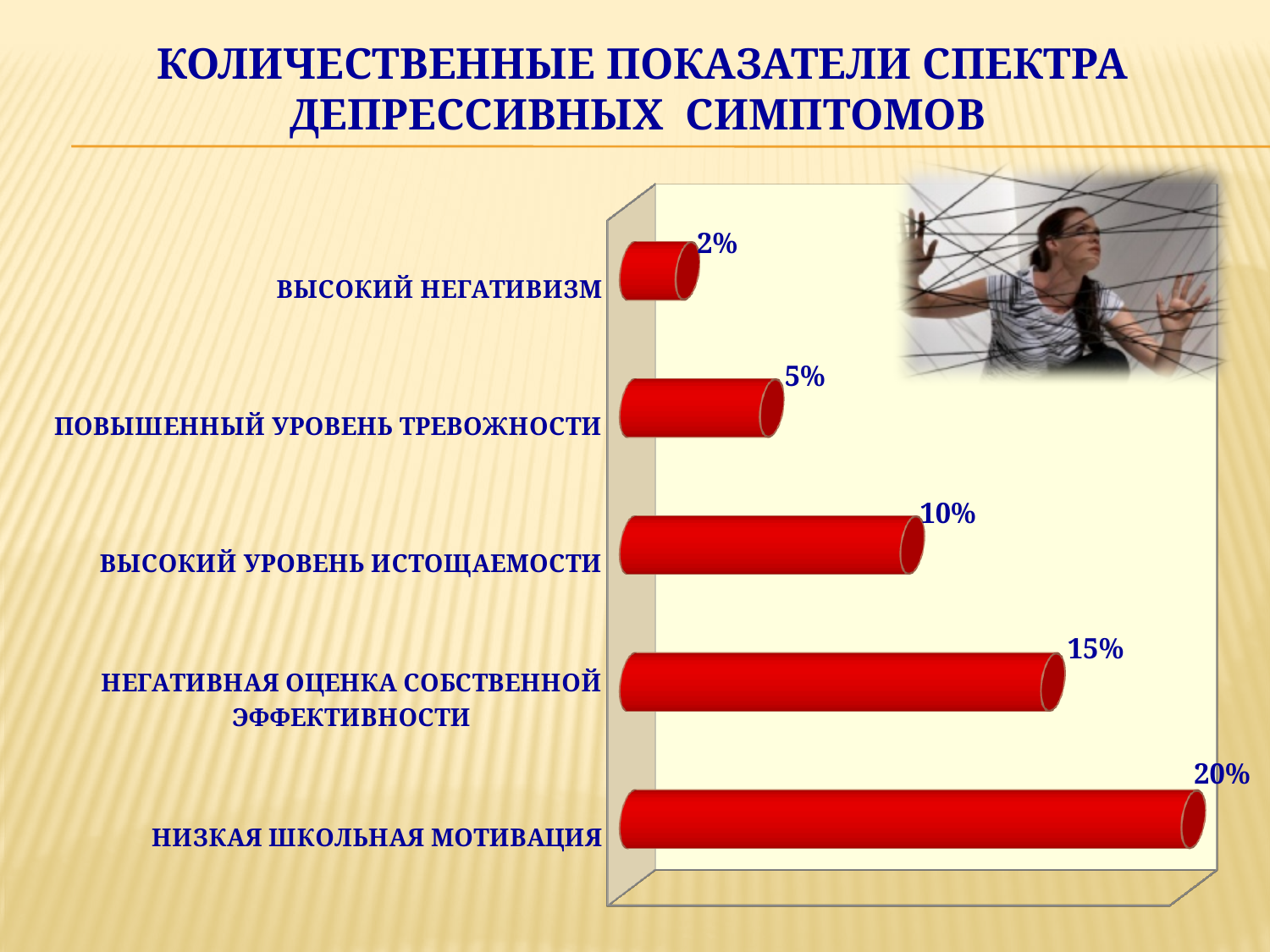
Which is larger: the value for ВЫСОКИЙ УРОВЕНЬ ИСТОЩАЕМОСТИ or the value for ПОВЫШЕННЫЙ УРОВЕНЬ ТРЕВОЖНОСТИ? ВЫСОКИЙ УРОВЕНЬ ИСТОЩАЕМОСТИ What is the difference between the values for НИЗКАЯ ШКОЛЬНАЯ МОТИВАЦИЯ and НЕГАТИВНАЯ ОЦЕНКА СОБСТВЕННОЙ ЭФФЕКТИВНОСТИ? 5% What is the value for НИЗКАЯ ШКОЛЬНАЯ МОТИВАЦИЯ? 20% What is the value for ПОВЫШЕННЫЙ УРОВЕНЬ ТРЕВОЖНОСТИ? 5% What colour are the bars in the chart? red What is the difference between the values for ВЫСОКИЙ УРОВЕНЬ ИСТОЩАЕМОСТИ and ВЫСОКИЙ НЕГАТИВИЗМ? 8% Which category has the lowest value? ВЫСОКИЙ НЕГАТИВИЗМ What kind of chart is shown on the slide? bar chart What is the value for ВЫСОКИЙ УРОВЕНЬ ИСТОЩАЕМОСТИ? 10% What is the value for ВЫСОКИЙ НЕГАТИВИЗМ? 2% How many categories are shown in the chart? 5 Which category has the highest value? НИЗКАЯ ШКОЛЬНАЯ МОТИВАЦИЯ